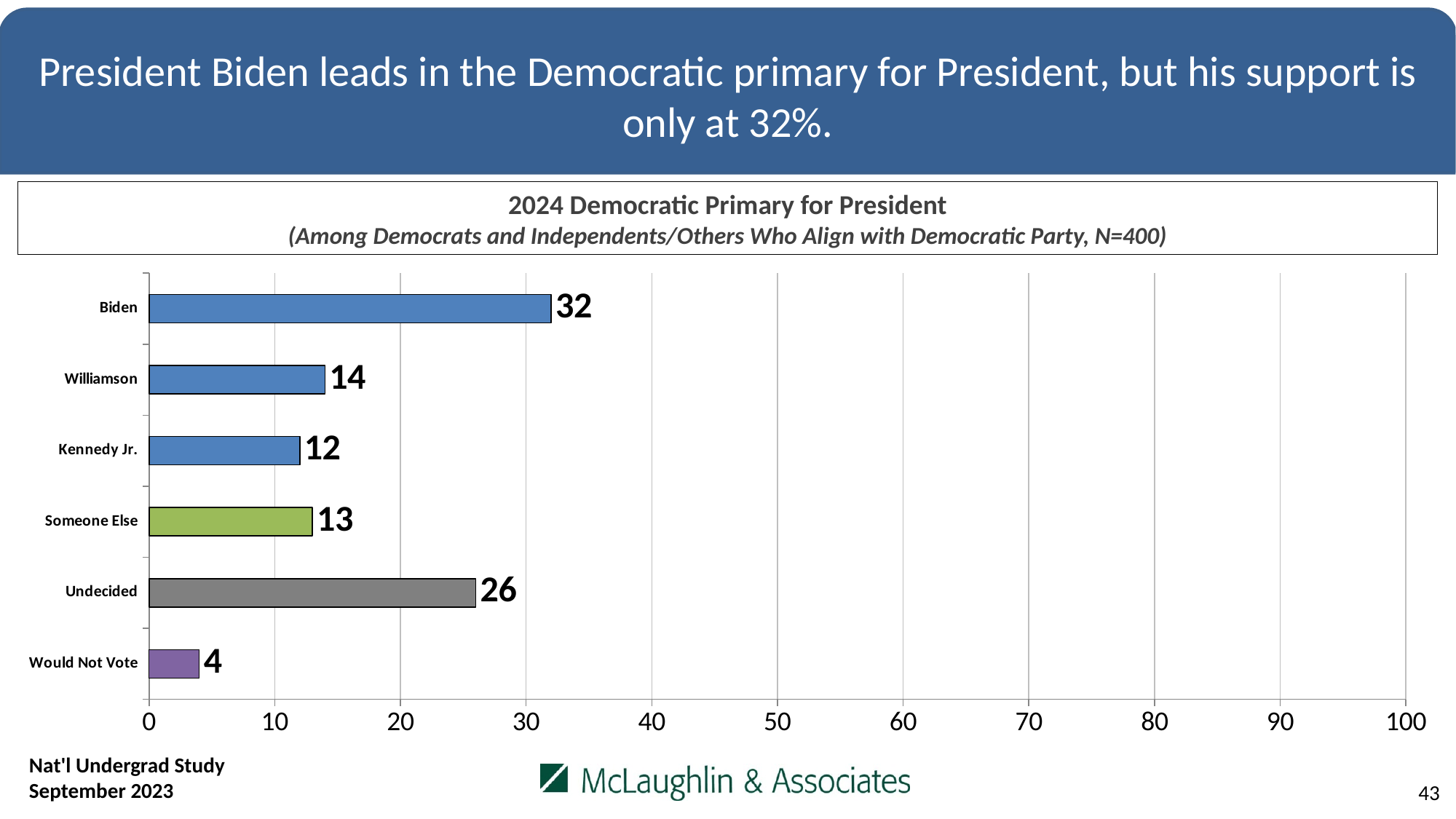
Is the value for Undecided greater or less than 30? less What is the value for Kennedy Jr.? 12 How many categories are shown in the chart? 6 What is the title of the chart? 2024 Democratic Primary for President Which category has the lowest value? Would Not Vote What is the value for Undecided? 26 What is the value for Would Not Vote? 4 What is the difference between the values for Biden and Undecided? 6 What is the value for Biden? 32 Which is larger, the value for Williamson or the value for Kennedy Jr.? Williamson Which category has the highest value? Biden What kind of chart is shown on the slide? bar chart